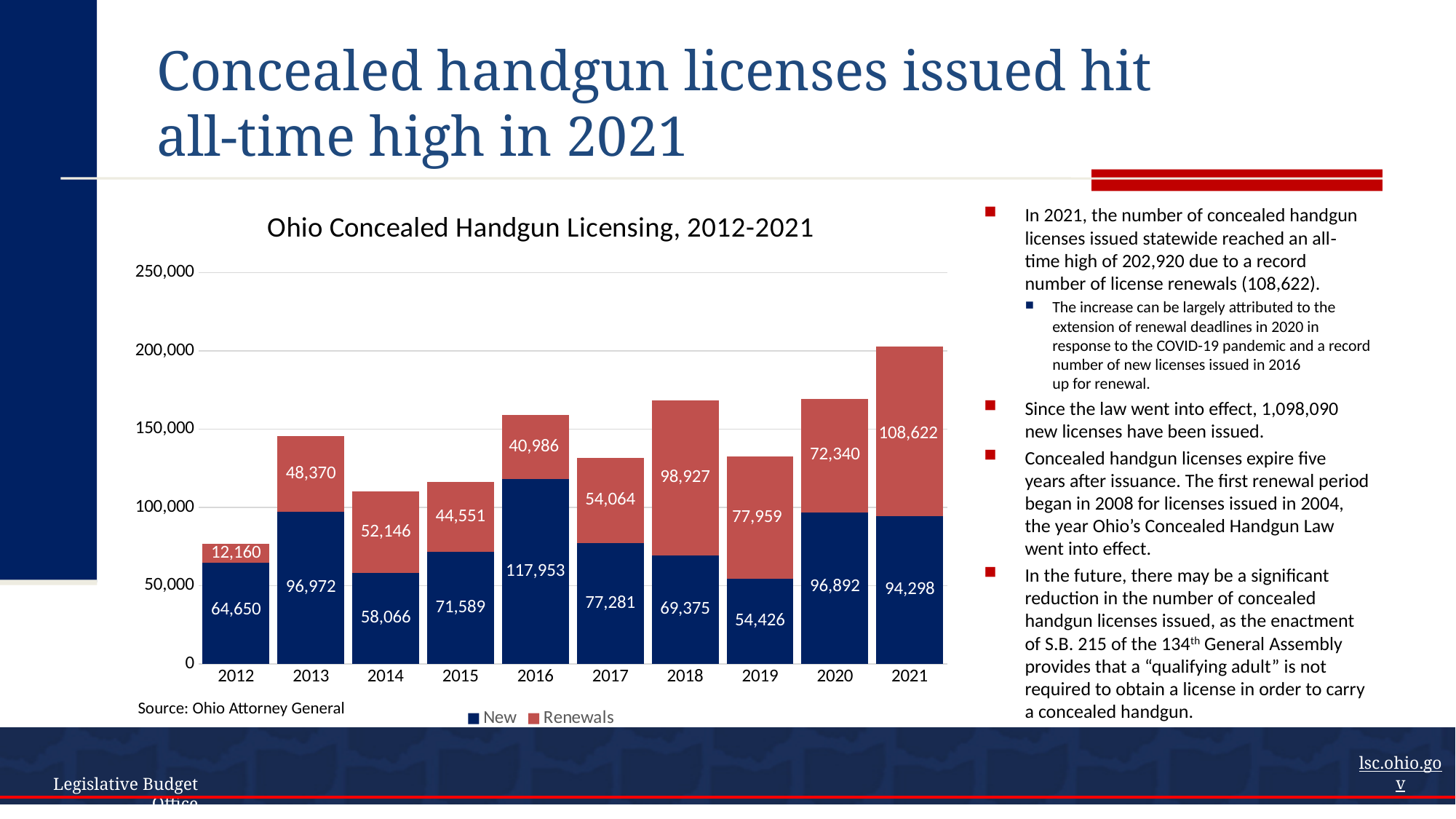
How many years are shown on the x axis of the chart? 10 Is the total height of the 2018 bar greater or less than 150,000? greater What is the difference between Renewals in 2021 and Renewals in 2020? 36,282 Which year has the lowest number of Renewals? 2012 What is the value for New licenses in 2016? 117,953 What is the total of the stacked bar for 2021 (New plus Renewals)? 202,920 What type of chart is shown on the slide? Stacked bar chart Which year has the highest number of New licenses? 2016 How many series does the chart legend list? 2 Which is larger: New licenses in 2015 or New licenses in 2019? New licenses in 2015 What is the title of the chart? Ohio Concealed Handgun Licensing, 2012-2021 What is the value for Renewals in 2018? 98,927